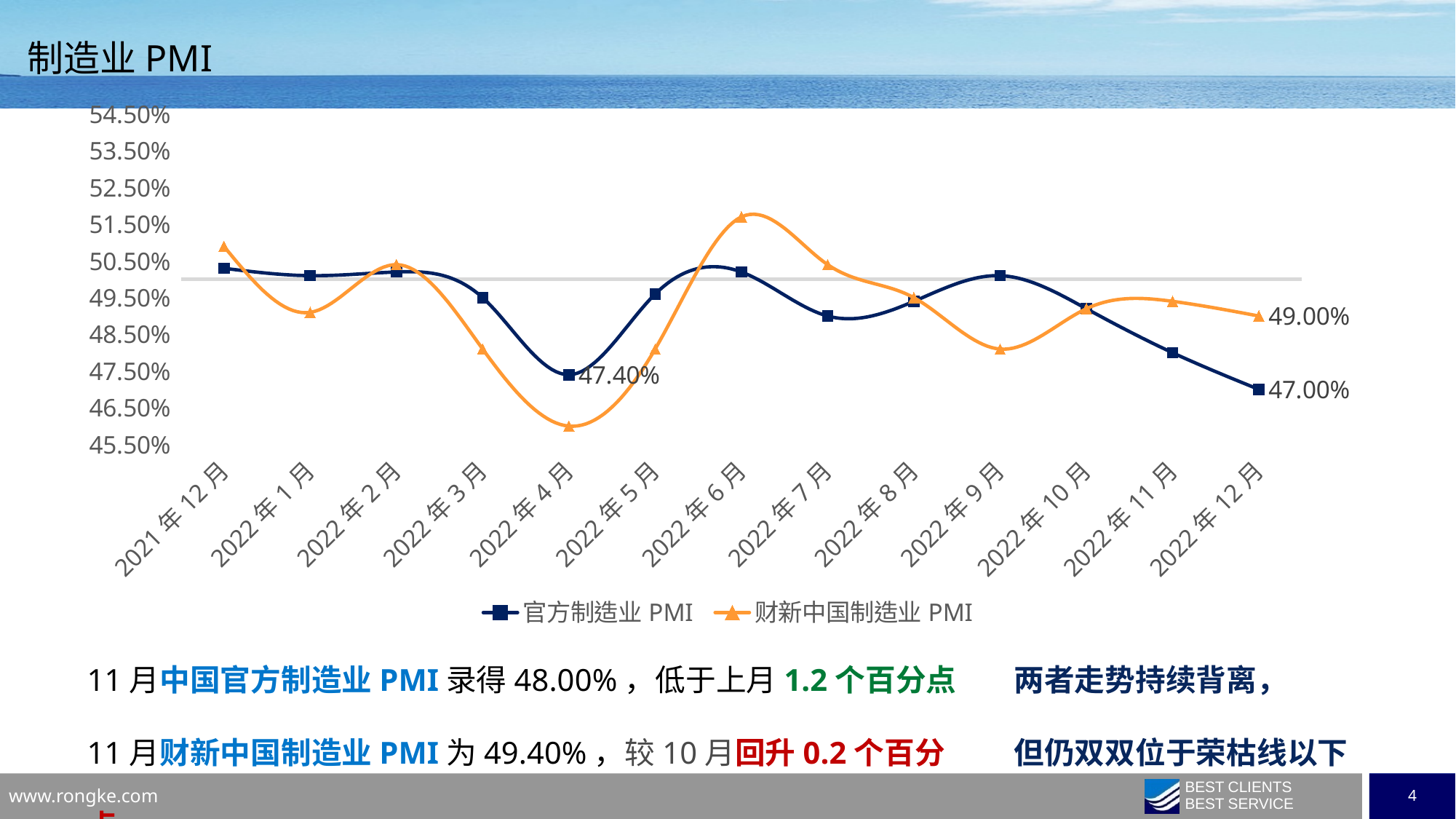
In which month does 财新中国制造业 PMI reach its lowest value? 2022年4月 How many series does the chart legend list? 2 What is the value of 官方制造业 PMI in 2022年4月? 47.40% Is the value for 财新中国制造业 PMI in 2022年4月 greater or less than 46.50%? less In which month does 财新中国制造业 PMI reach its highest value? 2022年6月 What is the value of 官方制造业 PMI in 2022年12月? 47.00% In 2022年12月, how much higher is 财新中国制造业 PMI than 官方制造业 PMI? 2.00% How many months (data points) are plotted along the x axis? 13 What is the value of 财新中国制造业 PMI in 2022年12月? 49.00% What kind of chart is shown on the slide? line chart In 2022年12月, which series has the higher value, 官方制造业 PMI or 财新中国制造业 PMI? 财新中国制造业 PMI From 2022年9月 to 2022年12月, does 官方制造业 PMI rise or fall? fall